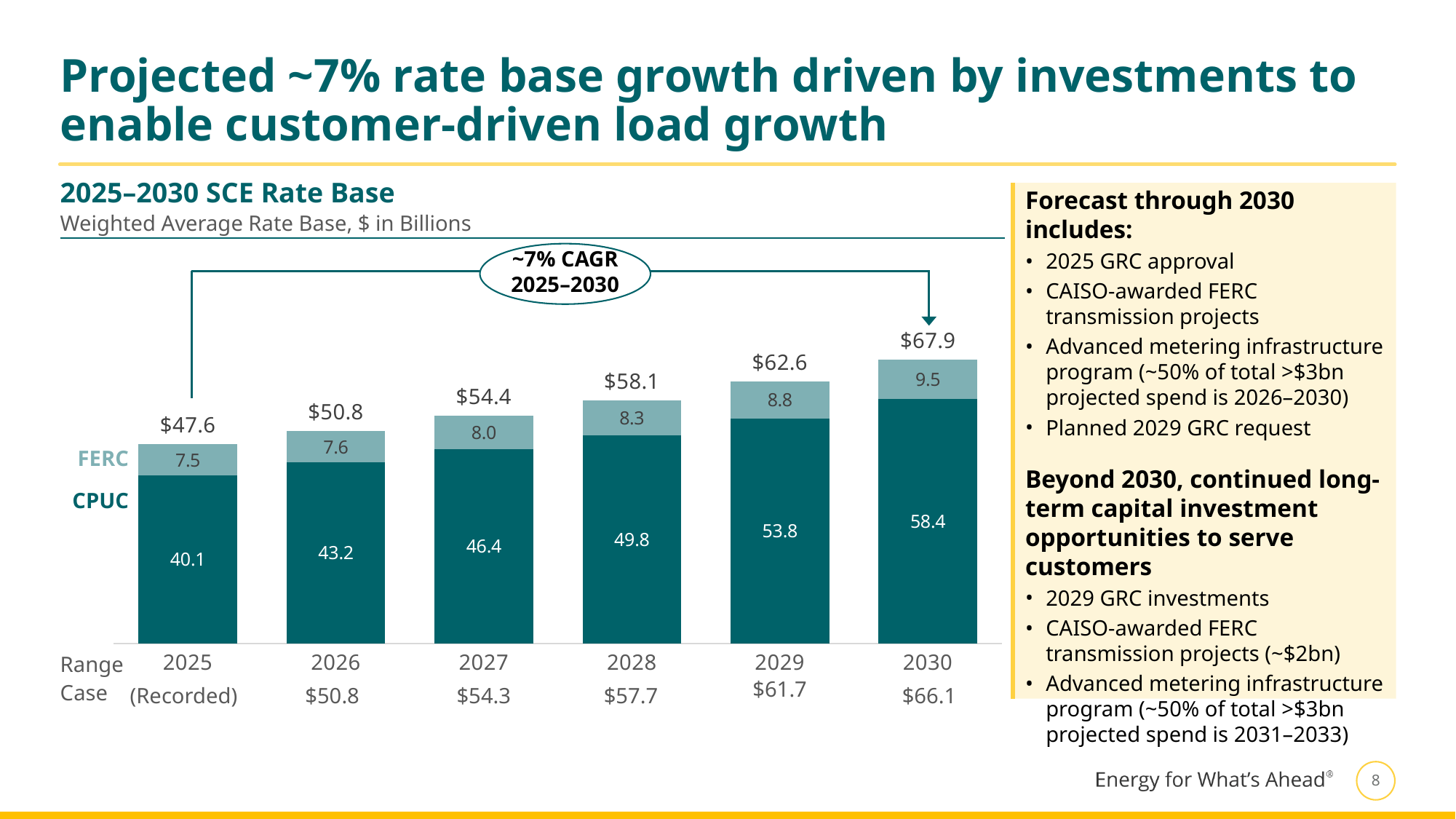
How many years are shown on the x axis? 6 Which year has the lowest CPUC value? 2025 What is the FERC value for 2029? 8.8 What is the difference between the total rate base in 2030 and in 2025? $20.3 How many series are stacked in each bar? 2 What kind of chart is this? Stacked bar chart Which year has the highest total rate base? 2030 What is the difference between the FERC values for 2028 and 2026? 0.7 Do the total rate base values rise or fall from 2025 to 2030? Rise What is the total rate base shown for 2030? $67.9 Is the CPUC value larger in 2028 or in 2026? 2028 What is the CPUC value for 2027? 46.4